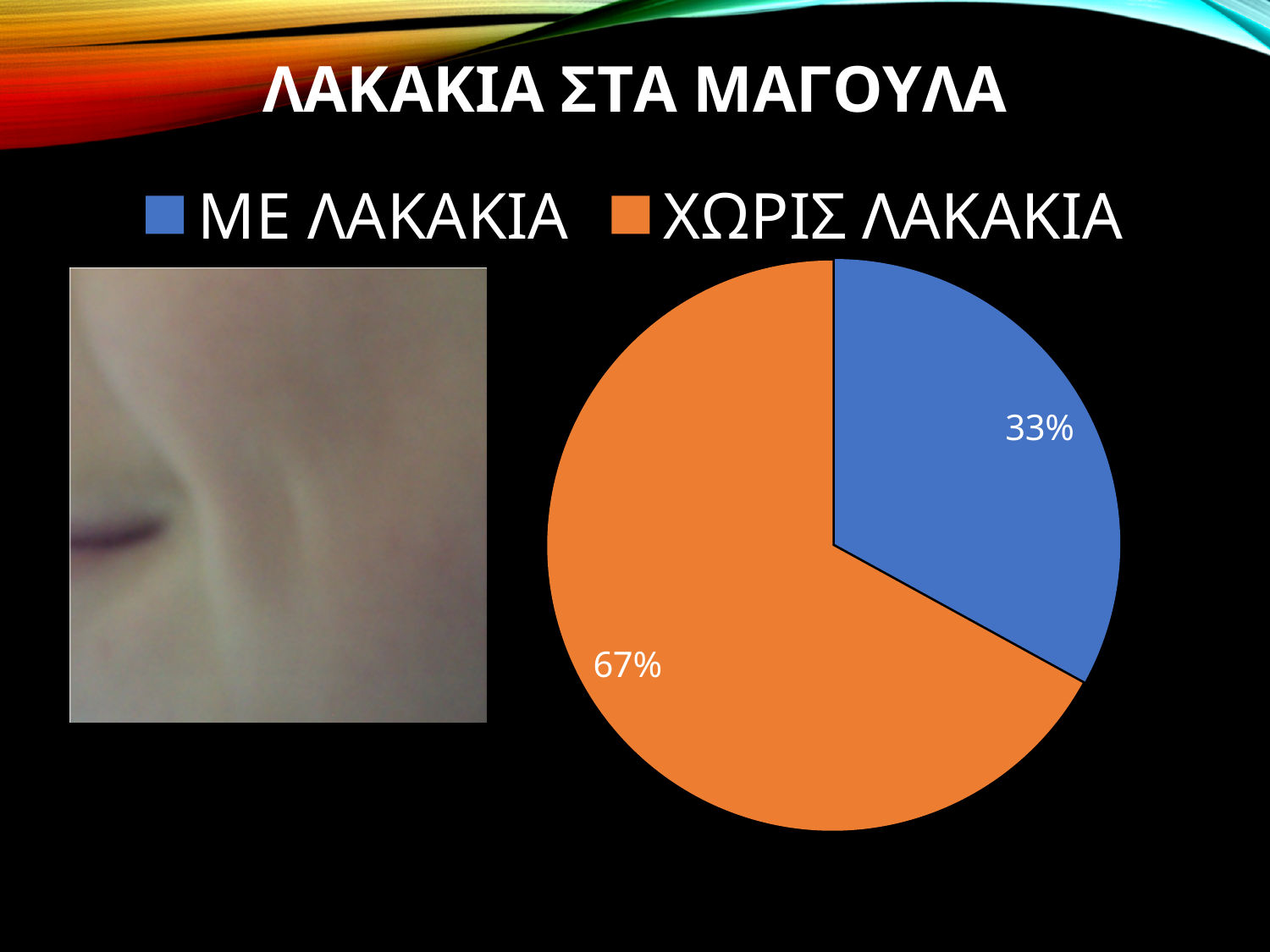
What is the title of the slide containing the chart? ΛΑΚΑΚΙΑ ΣΤΑ ΜΑΓΟΥΛΑ Which is larger, the share for ΜΕ ΛΑΚΑΚΙΑ or the share for ΧΩΡΙΣ ΛΑΚΑΚΙΑ? ΧΩΡΙΣ ΛΑΚΑΚΙΑ Which category has the largest share of the pie? ΧΩΡΙΣ ΛΑΚΑΚΙΑ What kind of chart is shown on the slide? pie chart What is the difference between the shares for ΧΩΡΙΣ ΛΑΚΑΚΙΑ and ΜΕ ΛΑΚΑΚΙΑ? 34% Which category has the smallest share of the pie? ΜΕ ΛΑΚΑΚΙΑ What share of the pie does the ΜΕ ΛΑΚΑΚΙΑ slice represent? 33% What is the value for ΜΕ ΛΑΚΑΚΙΑ? 33% What colour is the ΧΩΡΙΣ ΛΑΚΑΚΙΑ slice? orange What is the value for ΧΩΡΙΣ ΛΑΚΑΚΙΑ? 67% How many entries does the legend list? 2 How many slices does the pie chart have? 2